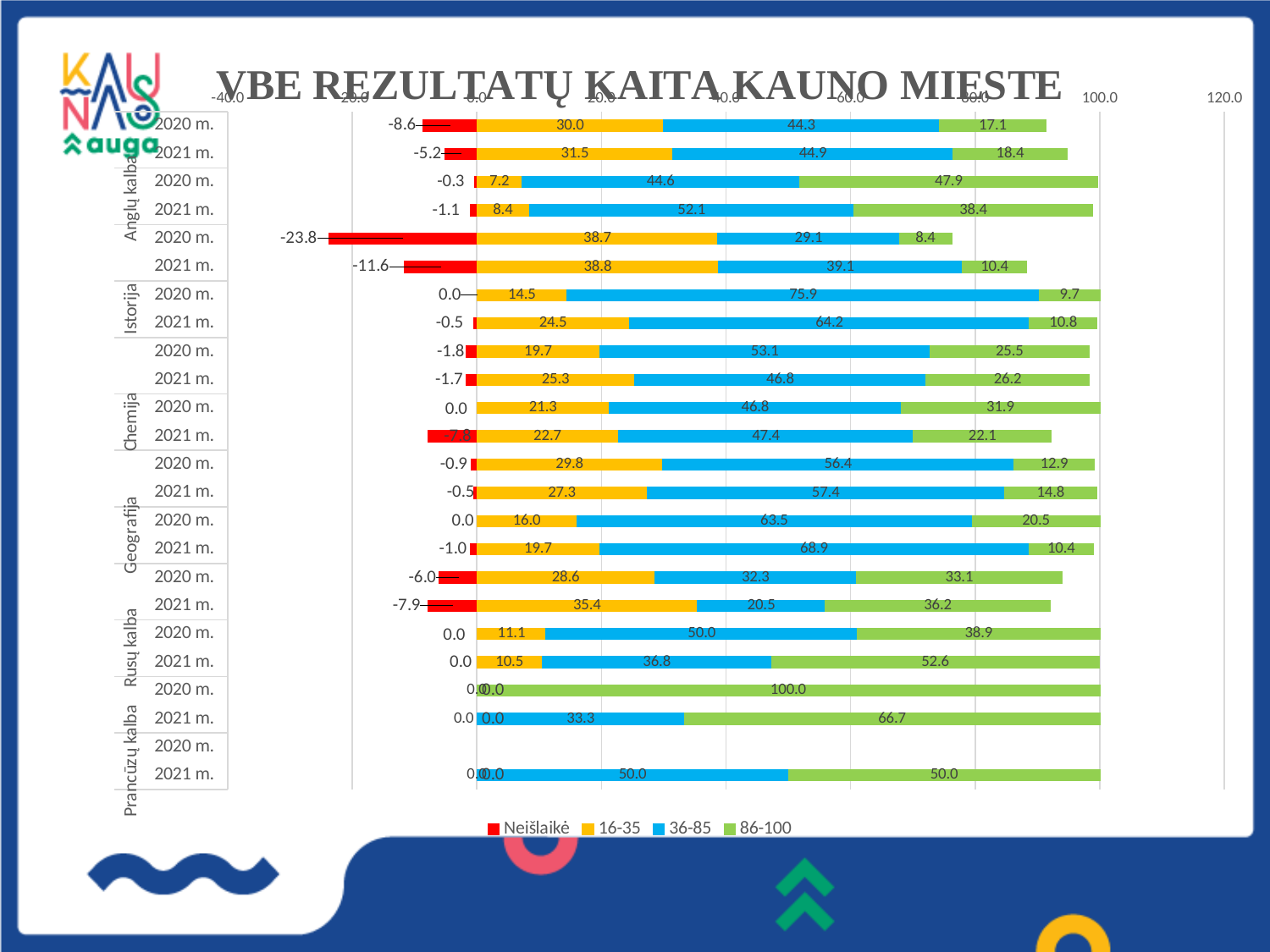
What is the most negative Neišlaikė value shown on the chart? -23.8 What is the largest 36-85 value shown on the chart? 75.9 How many series does the legend list? 4 In the top row of the chart (the first '2020 m.' bar), what is the Neišlaikė value? -8.6 In the top row of the chart (the first '2020 m.' bar), what is the value of the 16-35 segment? 30.0 What kind of chart is shown on the slide? bar chart In the top row of the chart (the first '2020 m.' bar), which segment is larger: 16-35 or 36-85? 36-85 In the top row of the chart (the first '2020 m.' bar), what is the difference between the 36-85 value and the 16-35 value? 14.3 In the bottom row of the chart (the last '2021 m.' bar), what is the value of the 36-85 segment? 50.0 What are the four legend entries of the chart? Neišlaikė, 16-35, 36-85, 86-100 What is the title of the chart? VBE REZULTATŲ KAITA KAUNO MIESTE What is the largest 86-100 value shown on the chart? 100.0